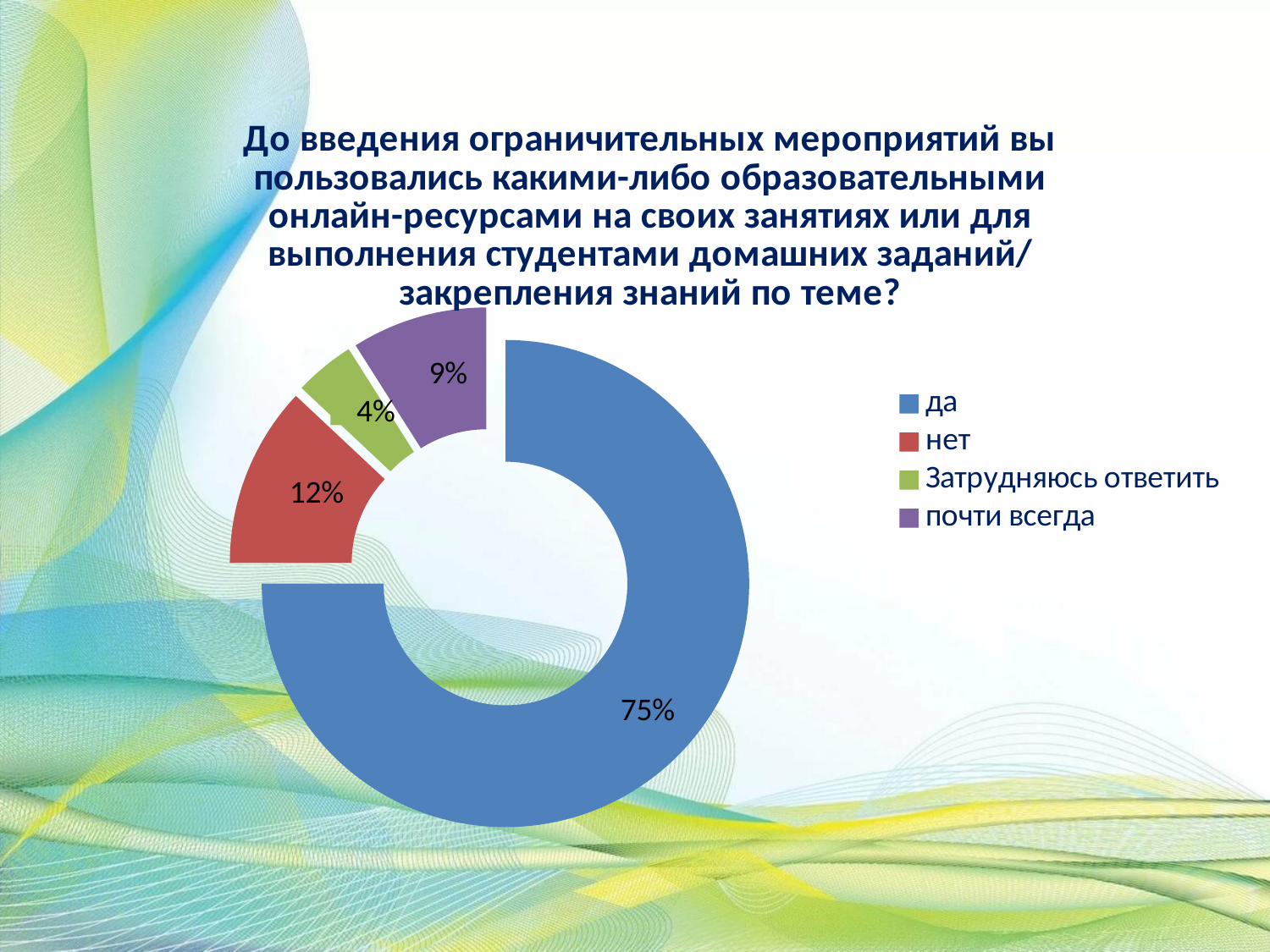
What kind of chart is shown on the slide? Doughnut (pie) chart Which is larger, the share for "нет" or the share for "почти всегда"? нет How many answer options are shown in the chart? 4 What is the difference in percentage points between "да" and "нет"? 63 What percentage of respondents answered "Затрудняюсь ответить"? 4% What percentage of respondents answered "почти всегда"? 9% Which answer option has the smallest share? Затрудняюсь ответить What percentage of respondents answered "да"? 75% What colour is the segment for "почти всегда"? Purple What percentage of respondents answered "нет"? 12% What is the combined share of "нет" and "Затрудняюсь ответить"? 16% Which answer option has the largest share? да